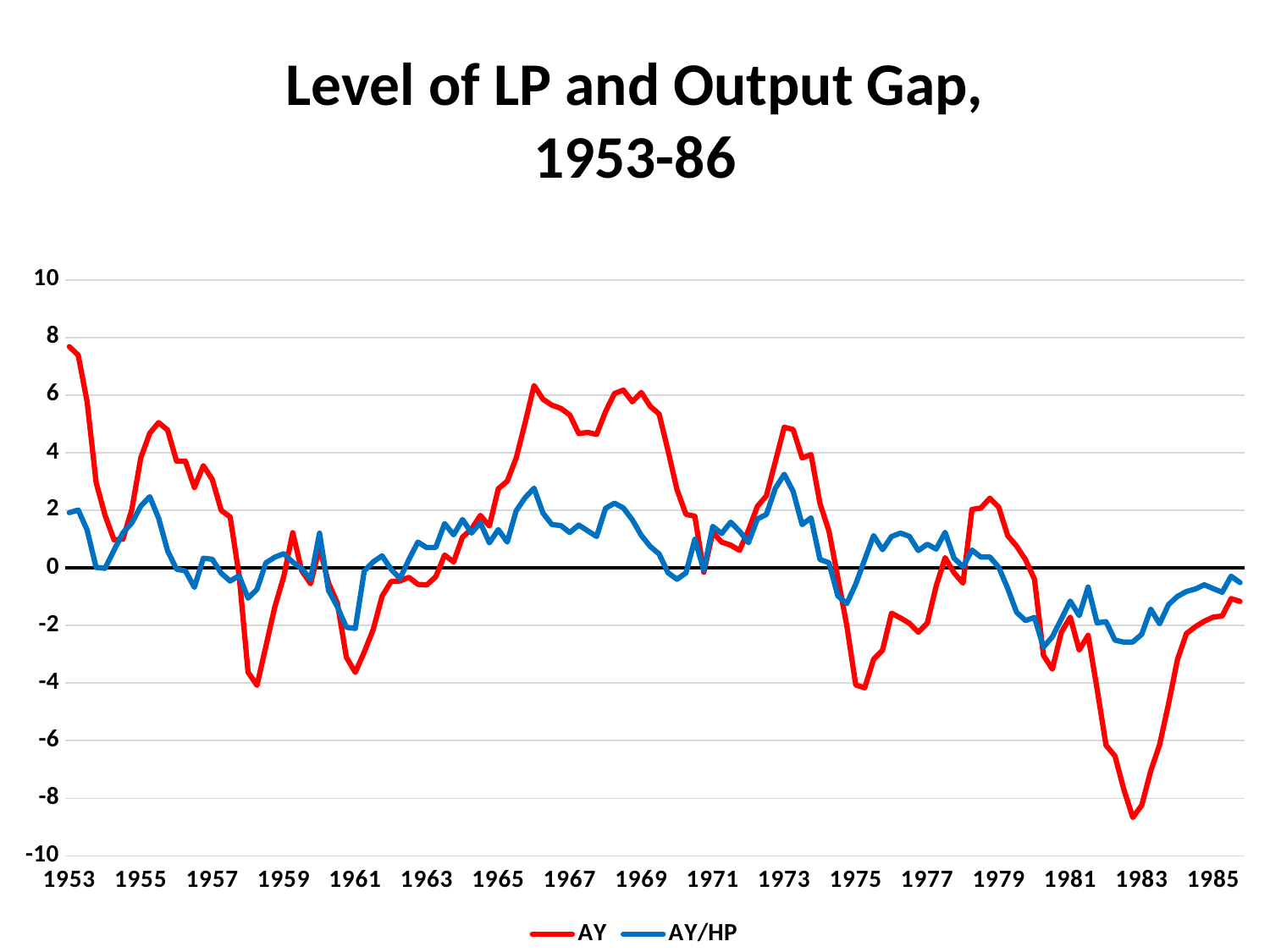
Is the peak of the AY/HP series around 1973 greater or less than 2? greater Around 1983, which series has the lower value, AY or AY/HP? AY In which year on the x axis does the AY series reach its lowest point? 1983 Is the lowest value of the AY series, reached around 1983, greater or less than -8? less What kind of chart is shown on the slide? line chart At 1953, which series has the higher value, AY or AY/HP? AY How many series does the legend list? 2 Is the value of the AY series at 1953 greater or less than 6? greater What is the title of the chart? Level of LP and Output Gap, 1953-86 Does the AY series rise or fall between 1981 and 1983? fall Which colour is used for the AY/HP series? blue